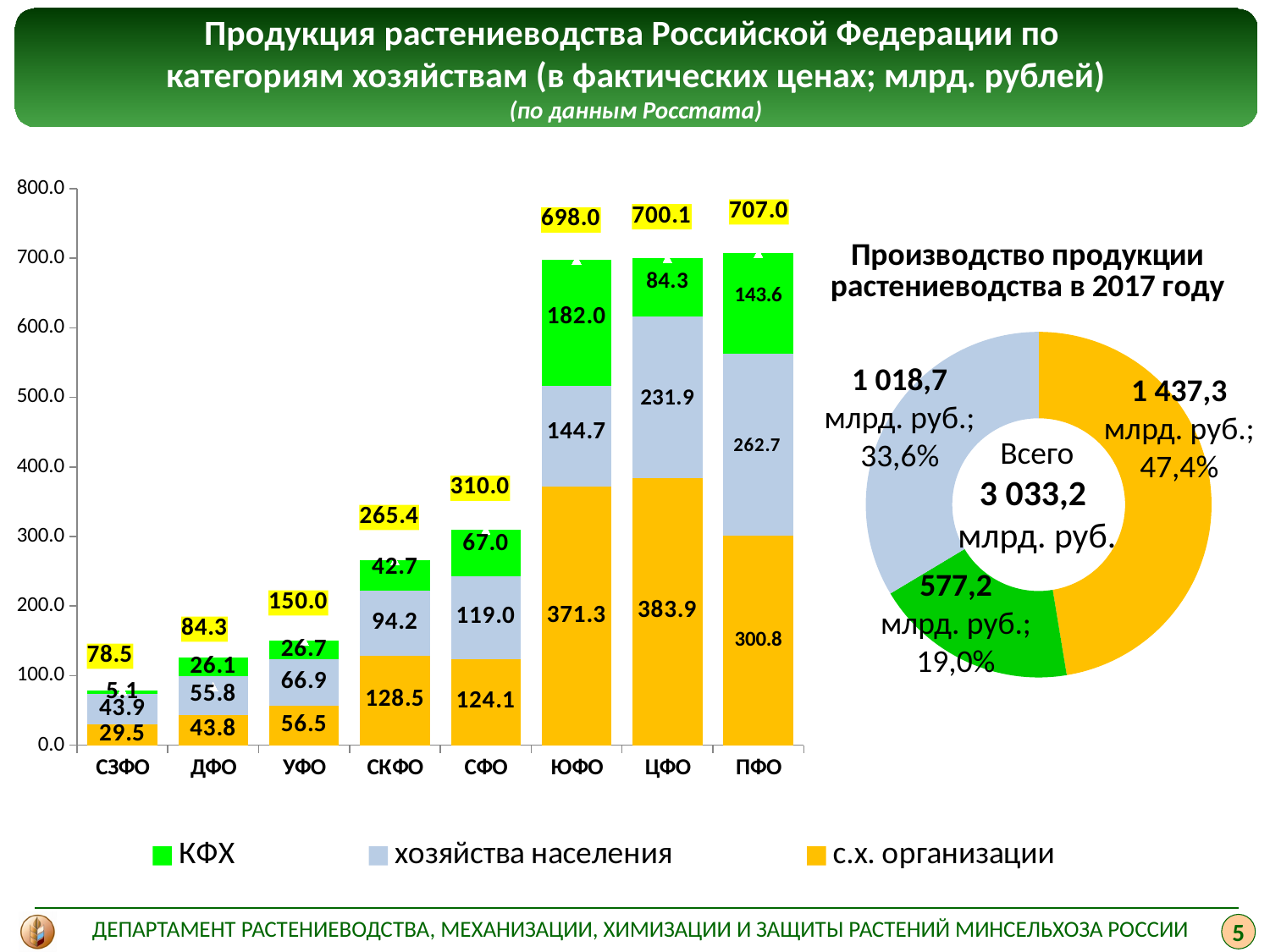
How many regions are shown on the x axis of the bar chart? 8 In the bar chart, what is the value for хозяйства населения in ЦФО? 231.9 In the chart titled 'Производство продукции растениеводства в 2017 году', what share does КФХ have? 19,0% What kind of chart is the chart titled 'Производство продукции растениеводства в 2017 году'? Pie (donut) chart In the bar chart, which is larger: the total for СФО or the total for СКФО? СФО In the bar chart, which region has the highest total value? ПФО In the bar chart, what is the total of the stacked bar for ЮФО? 698.0 How many series does the legend of the bar chart list? 3 In the bar chart, what is the value for КФХ in ПФО? 143.6 In the bar chart, what is the value for с.х. организации in ЮФО? 371.3 In the bar chart, which region has the lowest total value? СЗФО In the bar chart, what is the difference between the с.х. организации values for ЦФО and ЮФО? 12.6